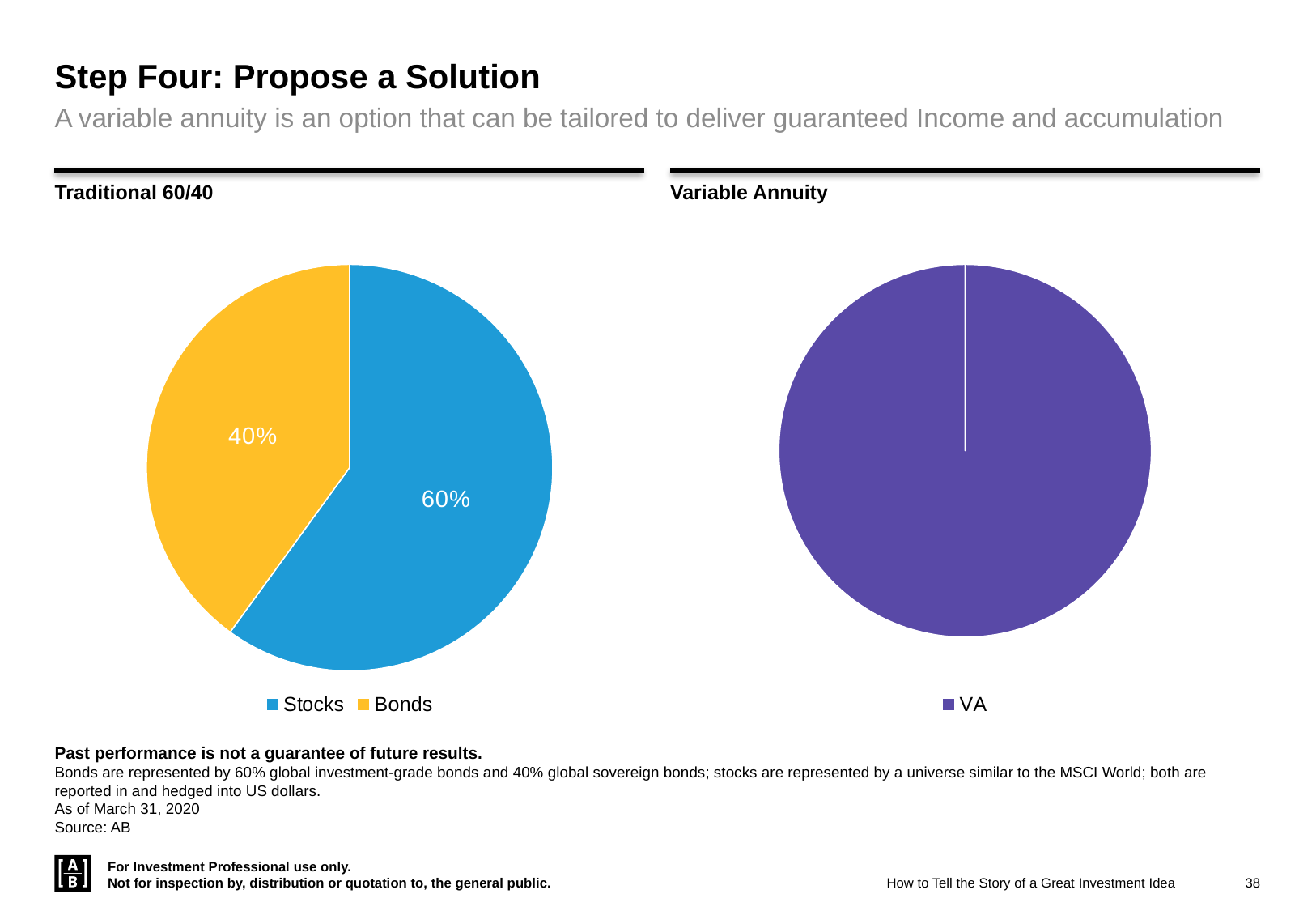
In the Traditional 60/40 chart, what share of the pie is Stocks? 60% How many categories does the legend of the Variable Annuity chart list? 1 What kind of chart is the Traditional 60/40 chart? Pie chart In the Traditional 60/40 chart, which category has the largest slice? Stocks In the Traditional 60/40 chart, which category has the smallest slice? Bonds How many categories does the legend of the Traditional 60/40 chart list? 2 What kind of chart is the Variable Annuity chart? Pie chart In the Traditional 60/40 chart, what is the difference in percentage points between the Stocks and Bonds slices? 20% In the Traditional 60/40 chart, which colour represents Bonds? Yellow What is the only legend entry in the Variable Annuity chart? VA In the Traditional 60/40 chart, what share of the pie is Bonds? 40% In the Traditional 60/40 chart, which slice is larger, Stocks or Bonds? Stocks